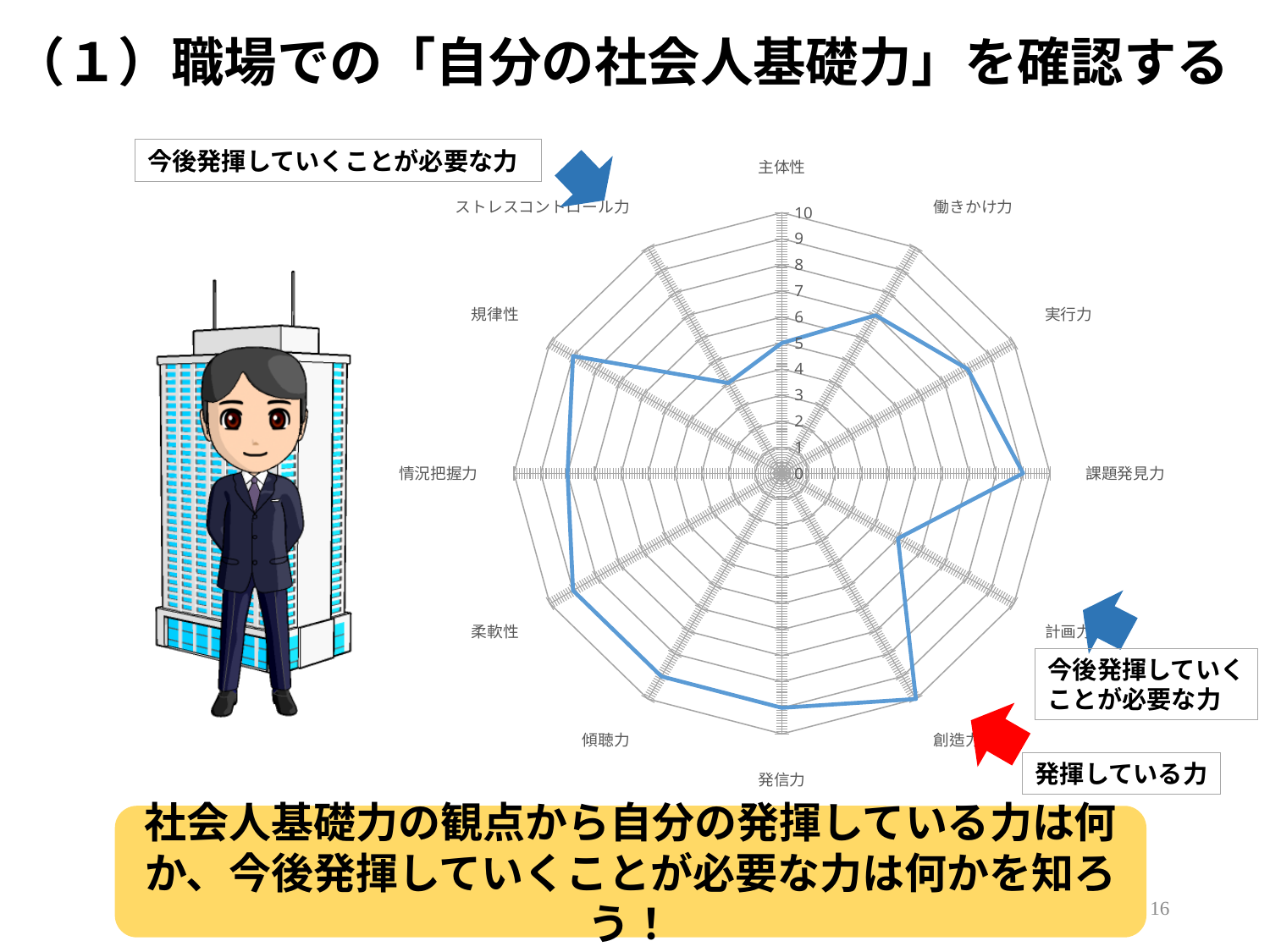
How many categories (axes) does the radar chart have? 12 Is the value for 創造力 greater or less than 8? greater Which has the larger value, 発信力 or 主体性? 発信力 Is the value for 課題発見力 greater or less than 8? greater What is the maximum value shown on the radar chart's axis scale? 10 Is the value for ストレスコントロール力 greater or less than 7? less What kind of chart is shown on the slide? radar chart Which category does the red arrow labelled 発揮している力 point to? 創造力 Which has the larger value, 課題発見力 or 計画力? 課題発見力